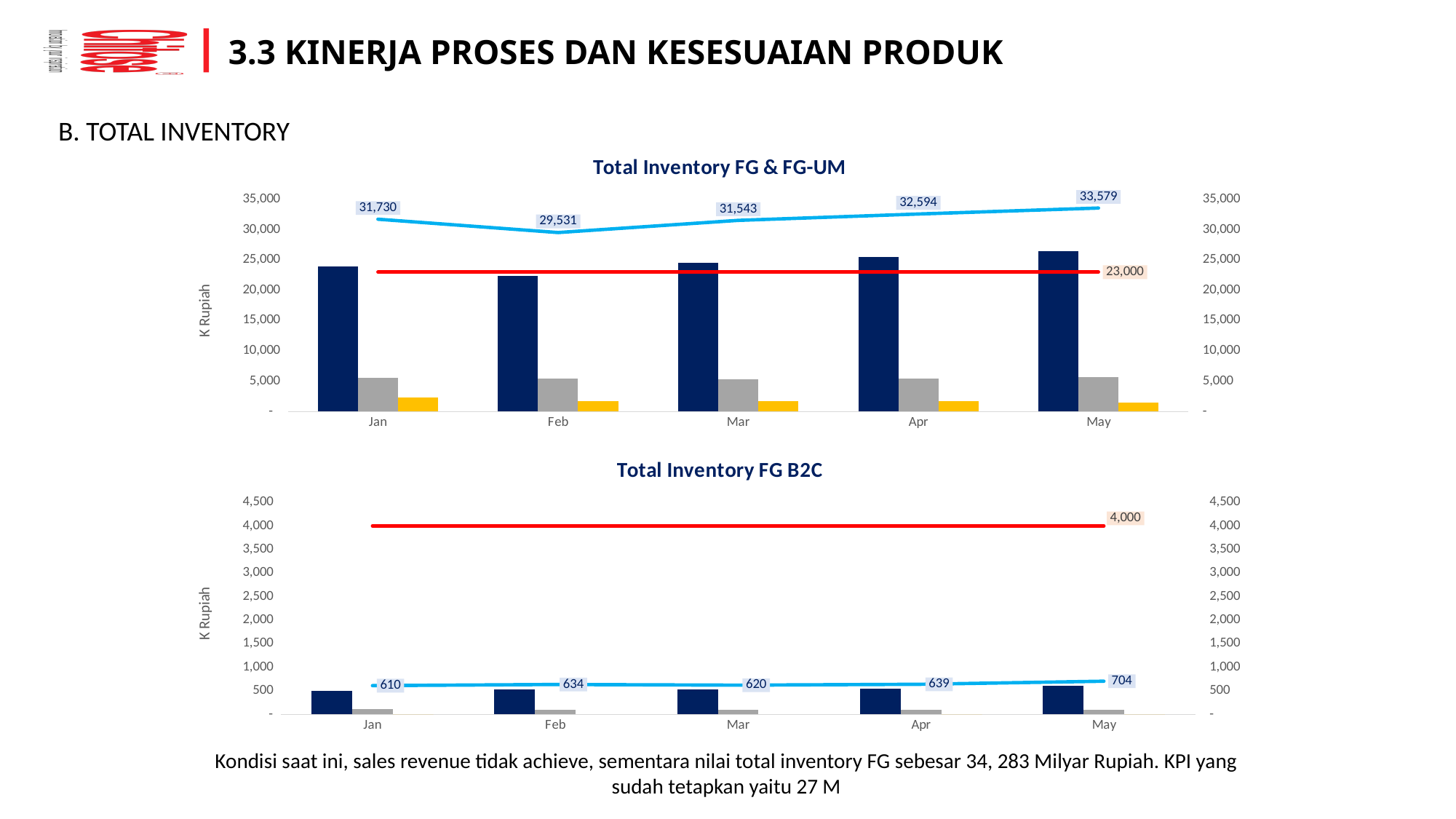
In the 'Total Inventory FG B2C' chart, what is the difference between the labelled line values for May and Jan? 94 In the 'Total Inventory FG B2C' chart, which month has the larger labelled line value, Feb or Mar? Feb In the 'Total Inventory FG & FG-UM' chart, what value is labelled on the red horizontal line? 23,000 What kind of chart is the top chart, 'Total Inventory FG & FG-UM'? A combined bar and line chart In the 'Total Inventory FG B2C' chart, what value is labelled on the red horizontal line? 4,000 In the 'Total Inventory FG & FG-UM' chart, what is the labelled line value for Feb? 29,531 In the 'Total Inventory FG & FG-UM' chart, what is the difference between the labelled line values for May and Jan? 1,849 In the 'Total Inventory FG & FG-UM' chart, which month has the lowest labelled line value? Feb How many months are shown on the x axis of the 'Total Inventory FG & FG-UM' chart? 5 In the 'Total Inventory FG & FG-UM' chart, which month has the highest labelled line value? May In the 'Total Inventory FG B2C' chart, which month has the lowest labelled line value? Jan In the 'Total Inventory FG B2C' chart, what is the labelled line value for May? 704